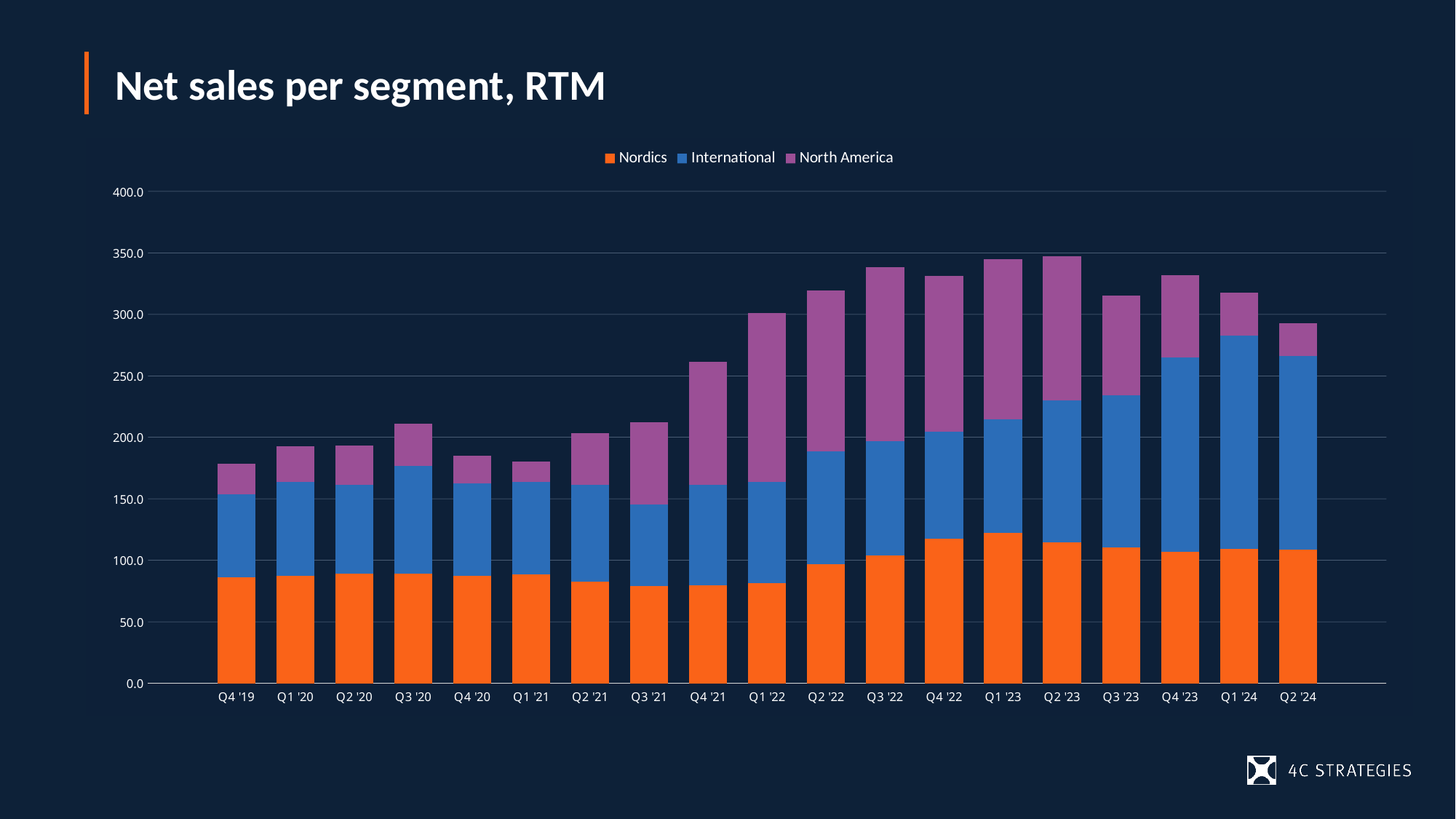
Which quarter has the larger total net sales, Q3 '20 or Q4 '20? Q3 '20 Do total net sales rise or fall from Q4 '21 to Q2 '23? rise What kind of chart is shown on the slide? Stacked bar chart Which segment is shown in purple in the chart? North America How many series does the legend list? 3 Is the total net sales for Q3 '22 greater or less than 300? greater What is the title of the chart? Net sales per segment, RTM Is the total net sales for Q4 '19 greater or less than 200? less How many quarters are shown on the x axis of the chart? 19 Is the total net sales for Q1 '24 greater or less than 300? greater Which quarter has the larger total net sales, Q2 '23 or Q2 '24? Q2 '23